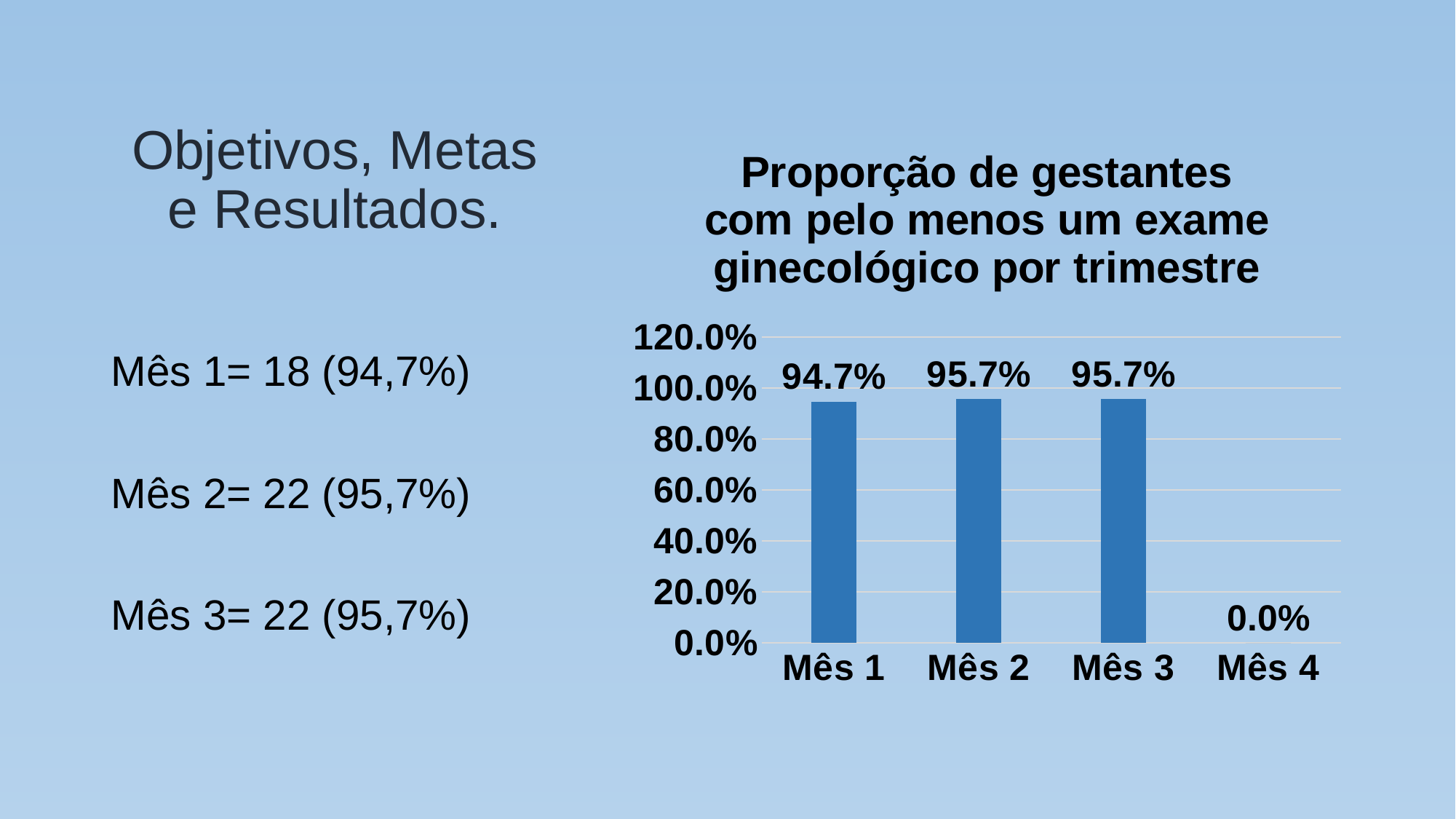
Is the value for Mês 3 greater or less than 80.0%? greater Which is larger, the value for Mês 1 or the value for Mês 4? Mês 1 What is the value for Mês 1? 94.7% What is the title of the chart? Proporção de gestantes com pelo menos um exame ginecológico por trimestre What is the value for Mês 3? 95.7% Which category has the lowest value? Mês 4 What kind of chart is shown on the slide? bar chart How many categories are shown on the x axis? 4 What is the value for Mês 2? 95.7% What is the highest value shown on the y axis? 120.0% What is the difference between the values for Mês 2 and Mês 1? 1.0% What is the value for Mês 4? 0.0%